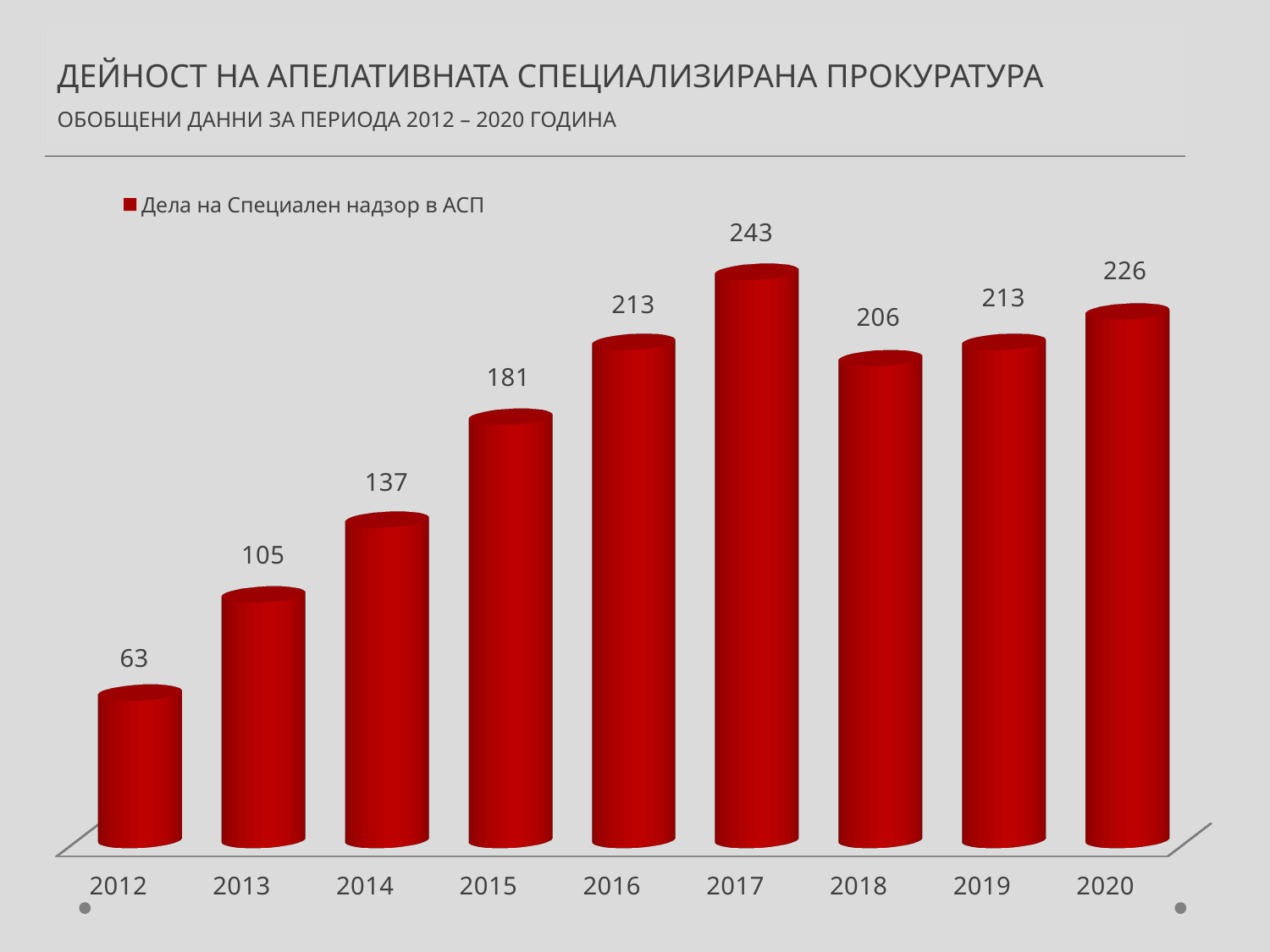
What is the difference between the values for 2017 and 2018? 37 What is the value for 2017? 243 Which is larger, the value for 2015 or the value for 2018? 2018 What kind of chart is shown on the slide? bar chart Do the values rise or fall from 2012 to 2017? rise What is the difference between the values for 2020 and 2012? 163 What is the value for 2020? 226 What is the value for 2012? 63 How many series does the legend list? 1 Which year has the highest value? 2017 How many years are shown on the x axis? 9 Which year has the lowest value? 2012